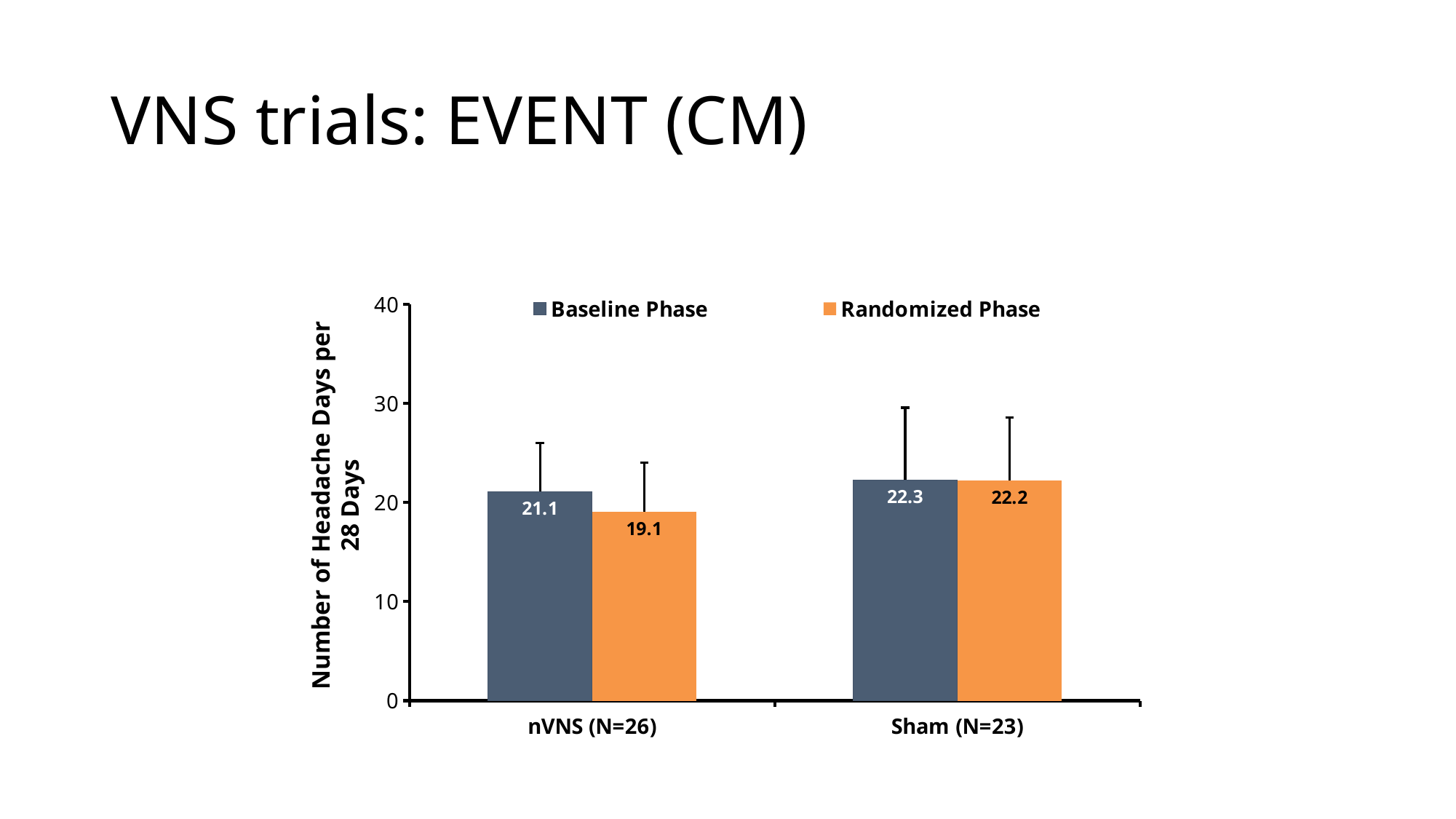
What is the Randomized Phase value for Sham (N=23)? 22.2 Is the Baseline Phase value for Sham (N=23) greater or less than 20? greater How many categories are shown on the x axis? 2 How many series does the legend list? 2 What is the Randomized Phase value for nVNS (N=26)? 19.1 What is the difference between the Baseline Phase and Randomized Phase values for nVNS (N=26)? 2.0 Which is larger: the Randomized Phase value for nVNS (N=26) or the Randomized Phase value for Sham (N=23)? Sham (N=23) What is the label of the y axis? Number of Headache Days per 28 Days What is the Baseline Phase value for Sham (N=23)? 22.3 Which bar has the lowest value on the chart? Randomized Phase for nVNS (N=26) What kind of chart is shown on the slide? bar chart What is the Baseline Phase value for nVNS (N=26)? 21.1